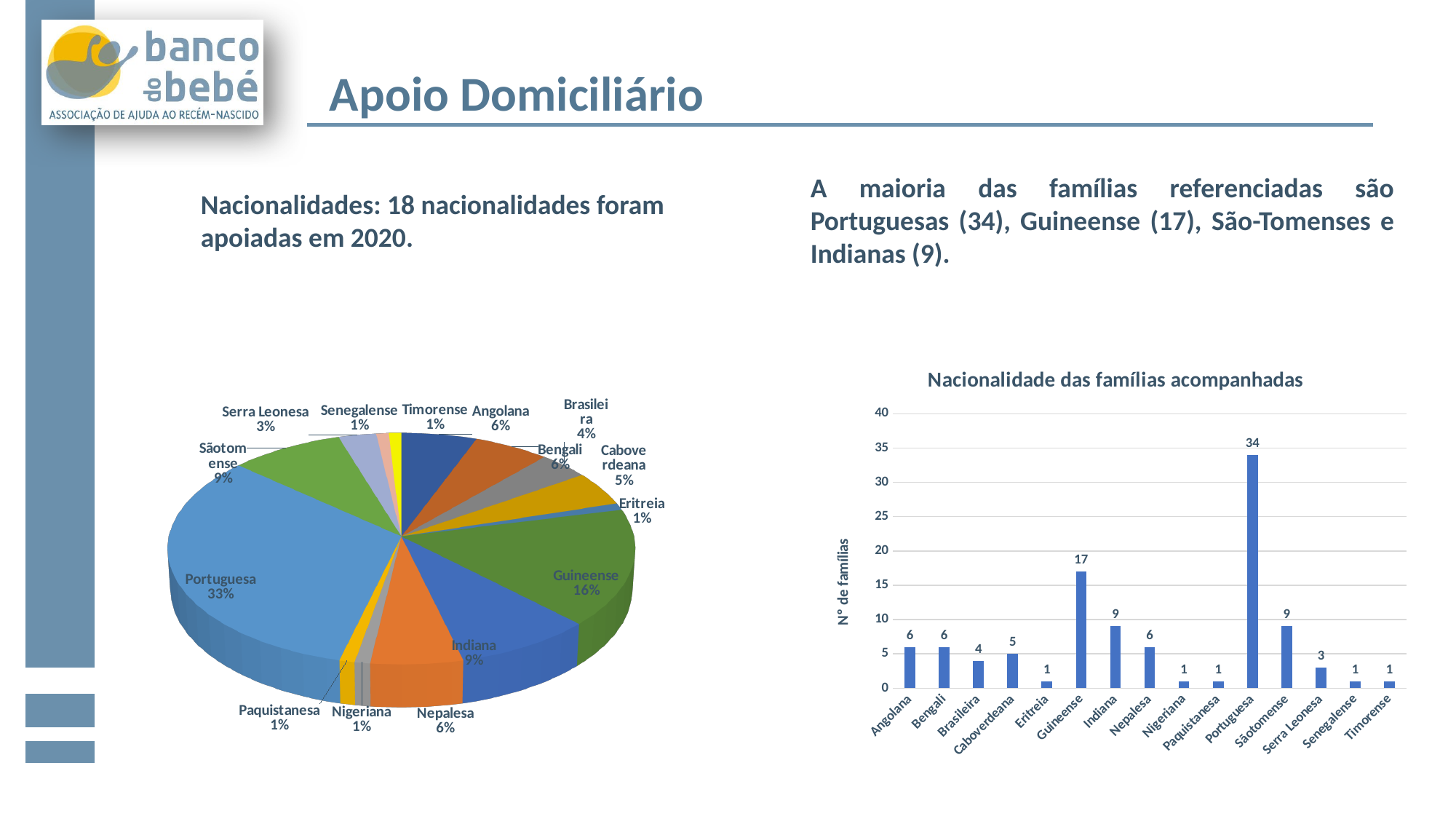
In the bar chart 'Nacionalidade das famílias acompanhadas', what is the label of the y axis? Nº de famílias In the pie chart on the left, what share does Portuguesa have? 33% In the bar chart 'Nacionalidade das famílias acompanhadas', what is the value for Portuguesa? 34 In the bar chart 'Nacionalidade das famílias acompanhadas', which is larger, the value for Indiana or the value for Nepalesa? Indiana In the bar chart 'Nacionalidade das famílias acompanhadas', what is the value for Guineense? 17 In the bar chart 'Nacionalidade das famílias acompanhadas', which category has the highest value? Portuguesa In the bar chart 'Nacionalidade das famílias acompanhadas', how many categories are shown on the x axis? 15 In the bar chart 'Nacionalidade das famílias acompanhadas', what is the difference between the values for Portuguesa and Guineense? 17 What kind of chart is the chart on the left of the slide? Pie chart In the pie chart on the left, which slice is the largest? Portuguesa What kind of chart is the chart on the right of the slide? Bar chart In the pie chart on the left, what share does Guineense have? 16%